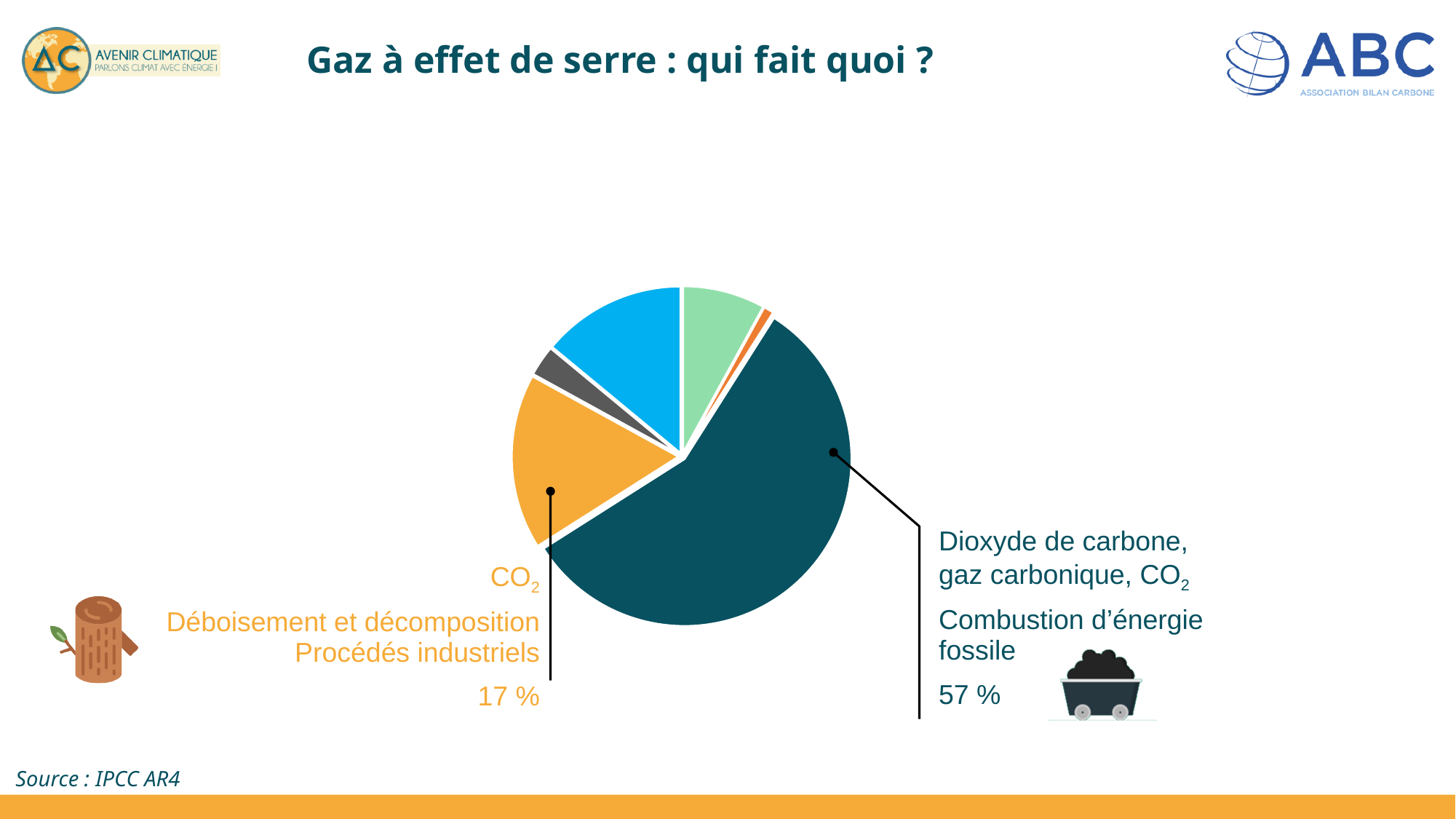
Which labelled source accounts for the largest slice of the pie? Combustion d'énergie fossile (CO2) What share of greenhouse gas emissions is attributed to CO2 from combustion of fossil energy (Combustion d'énergie fossile)? 57 % What share of greenhouse gas emissions is attributed to CO2 from deforestation, decomposition and industrial processes (Déboisement et décomposition, Procédés industriels)? 17 % What is the title of the slide containing the pie chart? Gaz à effet de serre : qui fait quoi ? What source is cited for the data in the pie chart? IPCC AR4 Is the share for Combustion d'énergie fossile greater or less than 50 %? greater What type of chart is shown on the slide? Pie chart What is the difference in percentage points between the Combustion d'énergie fossile share (57 %) and the Déboisement et décomposition / Procédés industriels share (17 %)? 40 % Which is larger: the share for Combustion d'énergie fossile or the share for Déboisement et décomposition / Procédés industriels? Combustion d'énergie fossile How many slices does the pie chart contain? 6